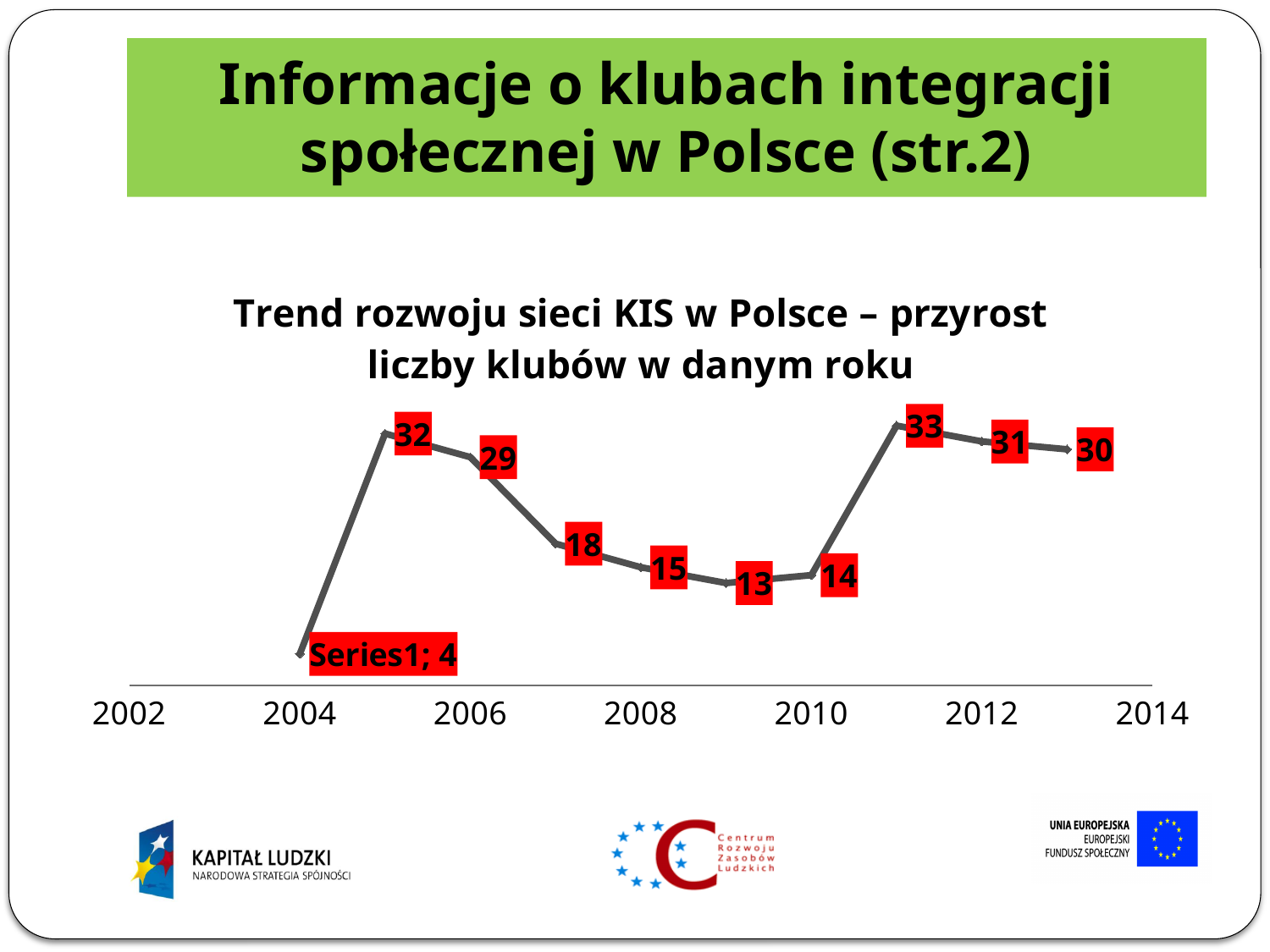
Which year has the larger value, 2010 or 2012? 2012 What is the highest value shown on the chart? 33 What type of chart is shown on the slide? line chart What is the value plotted for 2008? 15 What is the value plotted for 2012? 31 What is the difference between the values for 2006 and 2008? 14 Do the values rise or fall between 2006 and 2008? fall What is the lowest value shown on the chart? 4 What is the value plotted for 2010? 14 What is the value plotted for 2004? 4 How many data points are plotted on the chart? 10 What is the value plotted for 2006? 29